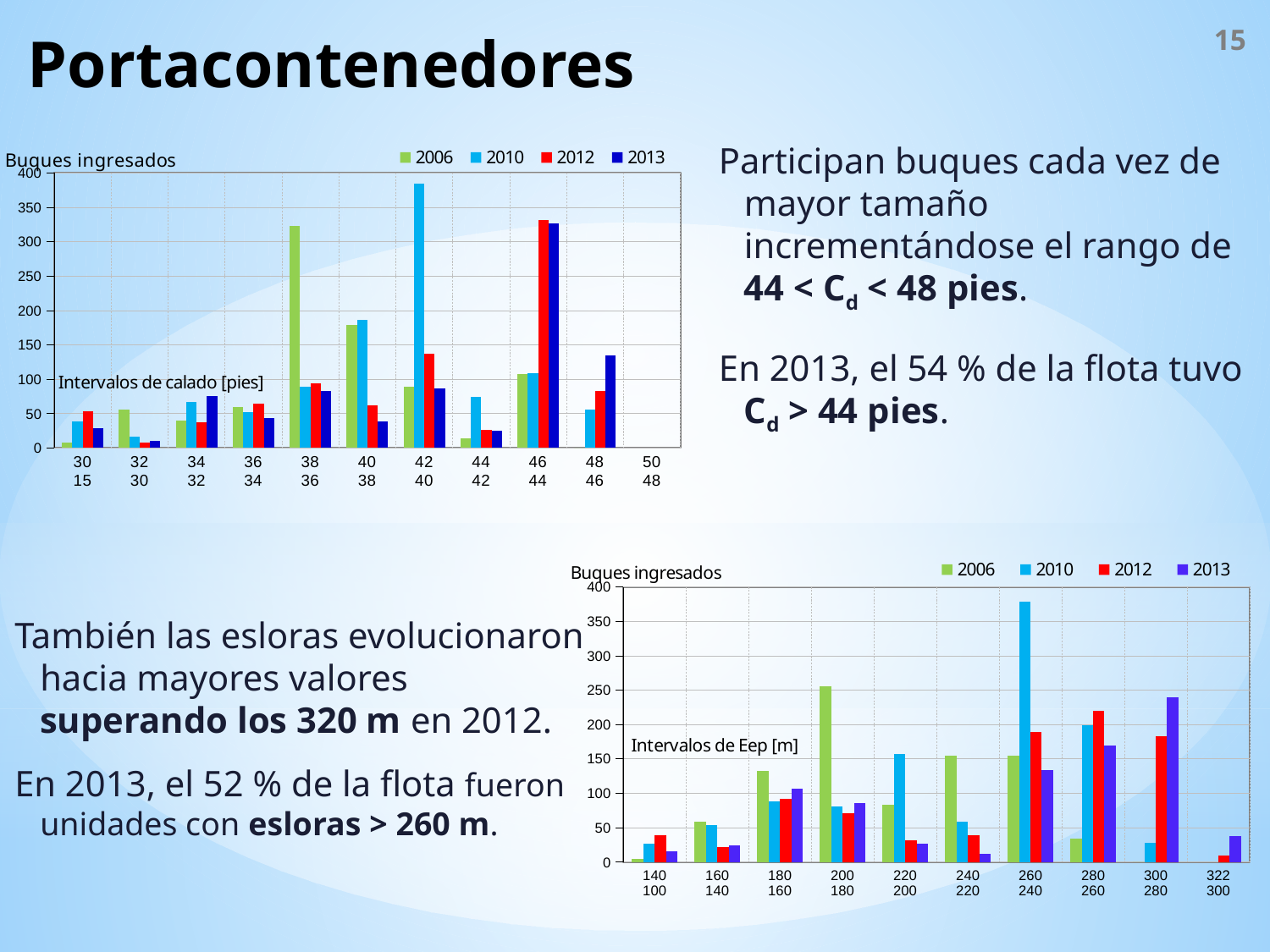
In the bottom chart (Intervalos de Eep [m]), is the 2013 value for the 300/280 interval greater or less than 200? greater How many length interval categories are shown on the x axis of the bottom chart (Intervalos de Eep [m])? 10 What is the y-axis label of the bottom chart (Intervalos de Eep [m])? Buques ingresados In the top chart (Intervalos de calado [pies]), which interval has the highest 2010 bar? 42/40 What kind of chart is the top chart (Intervalos de calado [pies])? bar chart In the top chart (Intervalos de calado [pies]), which is larger: the 2006 value for 38/36 or the 2006 value for 40/38? 38/36 How many draft interval categories are shown on the x axis of the top chart (Intervalos de calado [pies])? 11 In the top chart (Intervalos de calado [pies]), is the 2010 value for the 42/40 interval greater or less than 350? greater How many series does the legend of the top chart (Intervalos de calado [pies]) list? 4 In the bottom chart (Intervalos de Eep [m]), which is larger: the 2013 value for 300/280 or the 2013 value for 280/260? 300/280 In the top chart (Intervalos de calado [pies]), is the 2006 value for the 38/36 interval greater or less than 300? greater In the bottom chart (Intervalos de Eep [m]), which interval has the highest 2010 bar? 260/240